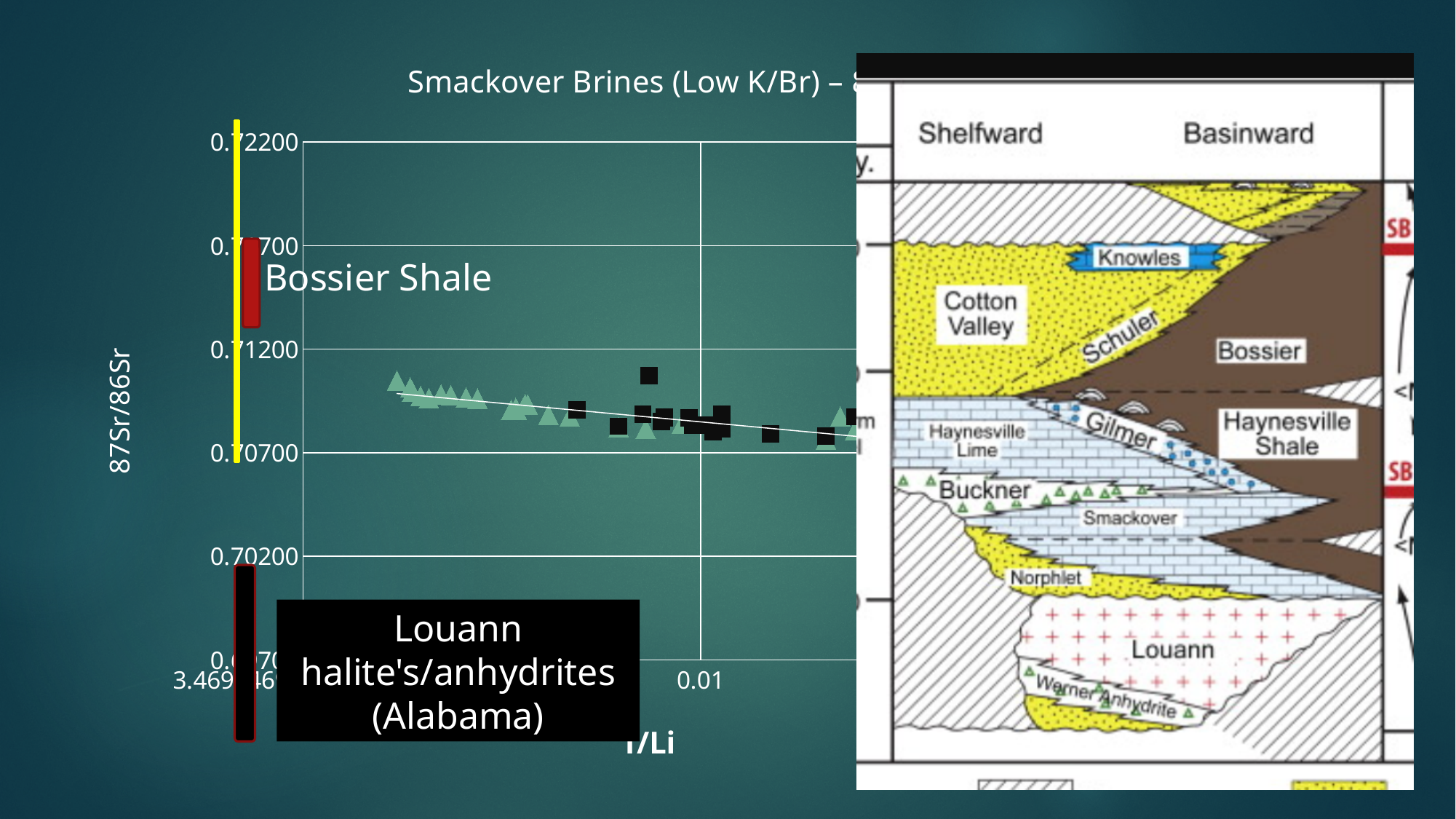
Do the plotted 87Sr/86Sr values rise or fall as the x-axis value increases? fall What is the highest tick value shown on the y axis of the scatter chart? 0.72200 Are the plotted data points in the scatter chart greater or less than 0.70700 on the y axis? greater Are the plotted data points in the scatter chart greater or less than 0.71200 on the y axis? less What kind of chart is shown on the left of the slide? scatter chart Which marker shape is used for the green series in the scatter chart? triangles What is the label of the y axis of the scatter chart? 87Sr/86Sr